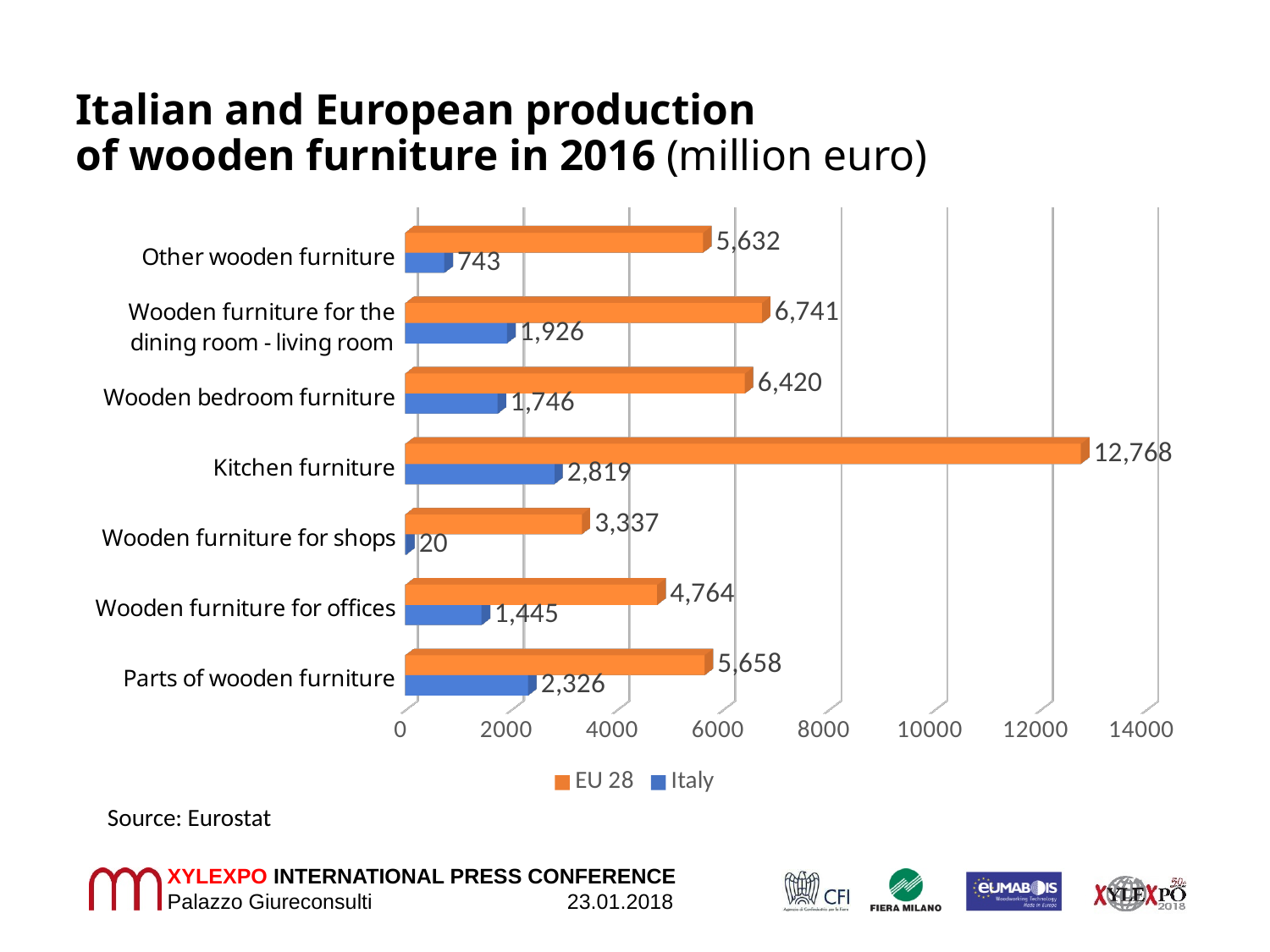
Which category has the highest EU 28 value? Kitchen furniture What is the EU 28 value for Wooden furniture for offices? 4,764 Which is larger, the EU 28 value for Wooden bedroom furniture or the EU 28 value for Wooden furniture for the dining room - living room? Wooden furniture for the dining room - living room What is the Italy value for Wooden furniture for shops? 20 How many series does the legend list? 2 What kind of chart is shown on the slide? Bar chart Which category has the lowest Italy value? Wooden furniture for shops What is the EU 28 value for Kitchen furniture? 12,768 What is the difference between the EU 28 and Italy values for Kitchen furniture? 9,949 How many categories are shown on the chart? 7 What is the Italy value for Parts of wooden furniture? 2,326 What is the source cited below the chart? Eurostat